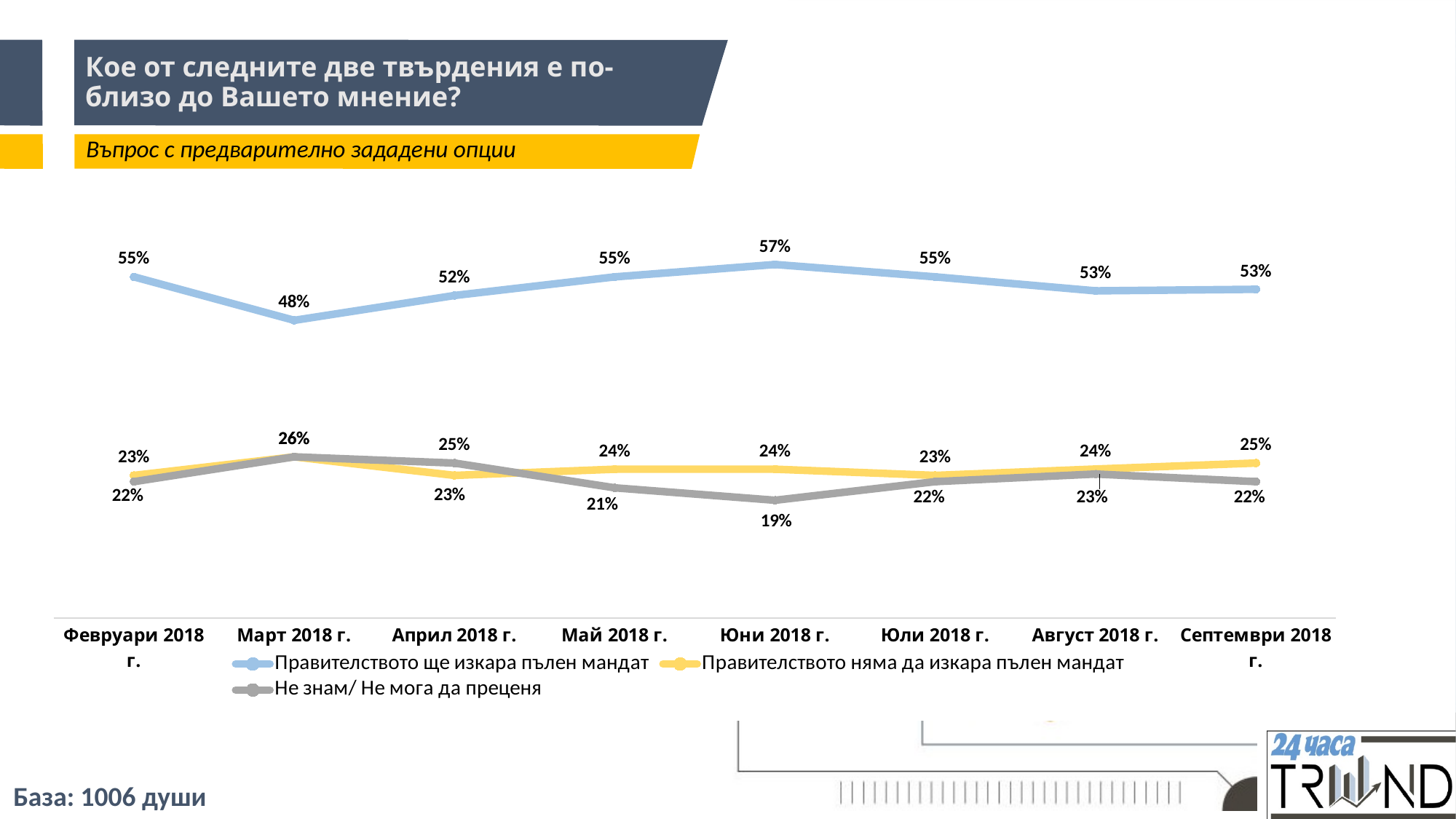
In which month is "Не знам/ Не мога да преценя" at its lowest? Юни 2018 г. In which month does "Правителството ще изкара пълен мандат" have its lowest value? Март 2018 г. How many months are shown on the x axis? 8 What is the value for "Правителството ще изкара пълен мандат" in Март 2018 г.? 48% In which month does "Правителството ще изкара пълен мандат" reach its highest value? Юни 2018 г. What kind of chart is shown on the slide? Line chart What is the value for "Не знам/ Не мога да преценя" in Юни 2018 г.? 19% How many series does the legend list? 3 By how many percentage points did "Правителството ще изкара пълен мандат" fall from Февруари 2018 г. to Март 2018 г.? 7 percentage points In Септември 2018 г., which is larger: "Правителството няма да изкара пълен мандат" or "Не знам/ Не мога да преценя"? Правителството няма да изкара пълен мандат What is the value for "Правителството ще изкара пълен мандат" in Юни 2018 г.? 57% What is the value for "Правителството няма да изкара пълен мандат" in Септември 2018 г.? 25%